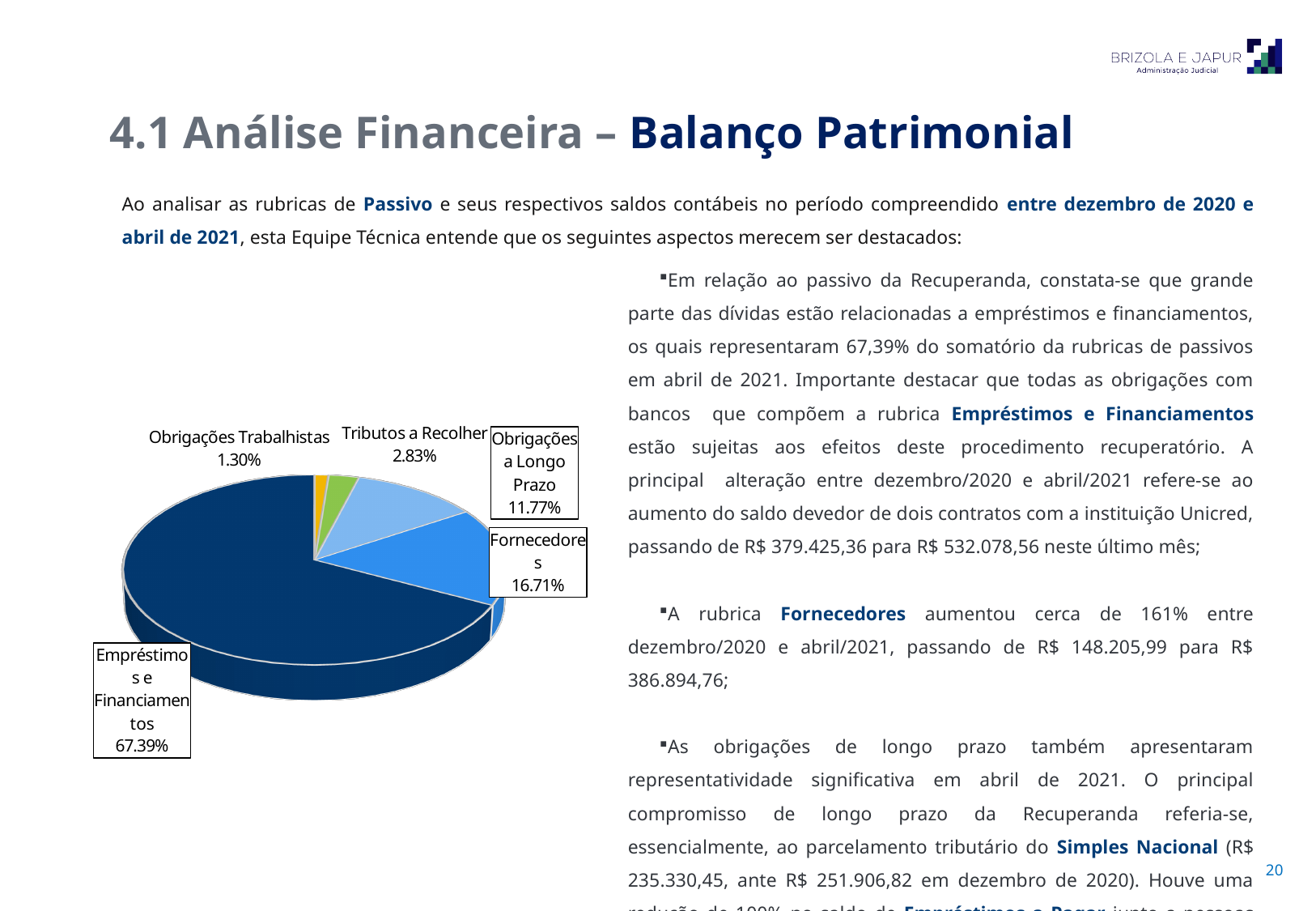
What is the combined share of Fornecedores and Obrigações a Longo Prazo? 28.48% What percentage is shown for Obrigações Trabalhistas? 1.30% What is the difference in percentage points between Fornecedores and Obrigações a Longo Prazo? 4.94 Which category has the largest slice of the pie? Empréstimos e Financiamentos What percentage is shown for Tributos a Recolher? 2.83% What percentage is shown for Fornecedores? 16.71% How many slices does the pie chart have? 5 What type of chart is shown on the slide? Pie chart What share of the pie does Empréstimos e Financiamentos represent? 67.39% Which category has the smallest slice of the pie? Obrigações Trabalhistas Which is larger, Tributos a Recolher or Obrigações Trabalhistas? Tributos a Recolher What percentage is shown for Obrigações a Longo Prazo? 11.77%